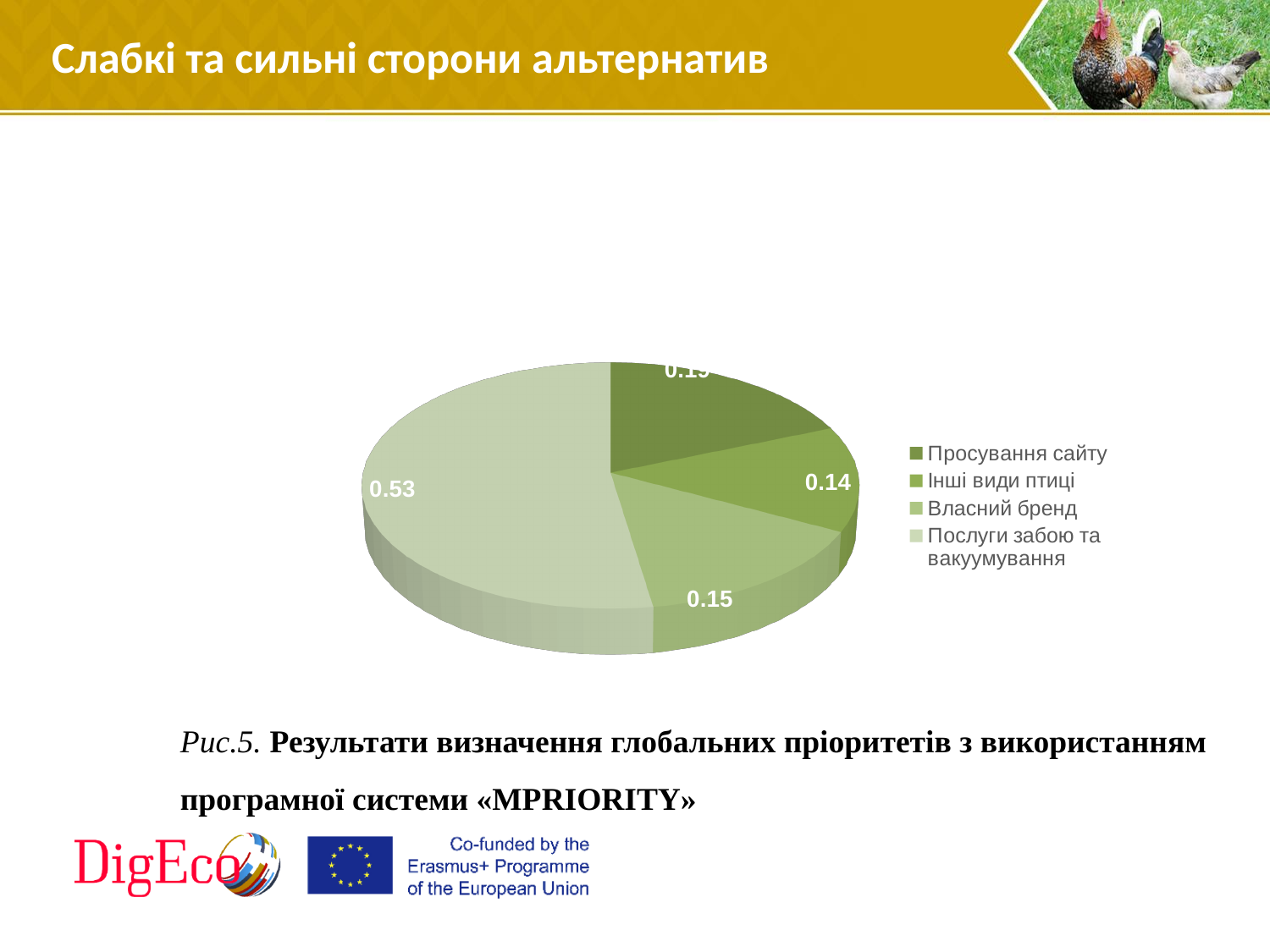
Which category is listed first in the legend? Просування сайту Which category has the smallest value in the pie chart? Інші види птиці Which is larger, the value for Власний бренд or the value for Інші види птиці? Власний бренд What is the value shown for Послуги забою та вакуумування? 0.53 What is the value shown for Інші види птиці? 0.14 What kind of chart is shown on the slide? pie chart How many entries does the legend list? 4 Which category has the largest slice of the pie? Послуги забою та вакуумування How many slices does the pie chart have? 4 What is the value shown for Власний бренд? 0.15 What is the difference between the values for Власний бренд and Інші види птиці? 0.01 What is the difference between the values for Послуги забою та вакуумування and Власний бренд? 0.38